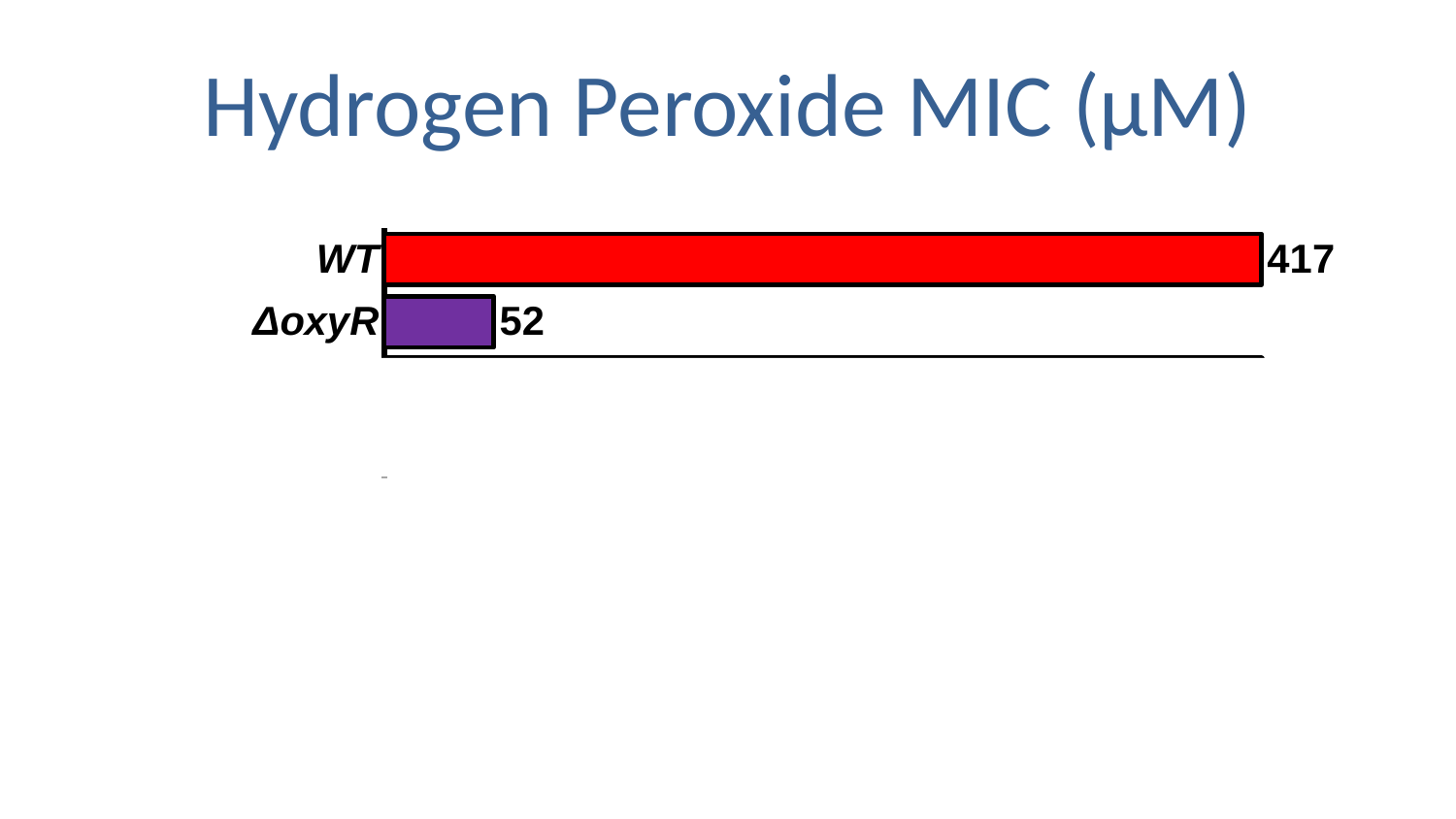
What is the title of the chart? Hydrogen Peroxide MIC (μM) What is the hydrogen peroxide MIC value shown for ΔoxyR? 52 Which category has the lowest value in the chart? ΔoxyR What colour is the bar for ΔoxyR? purple What is the difference between the WT and ΔoxyR values? 365 What kind of chart is shown on the slide? bar chart Which has a larger value, WT or ΔoxyR? WT What is the hydrogen peroxide MIC value shown for WT? 417 How many categories are plotted in the chart? 2 Which category has the highest value in the chart? WT